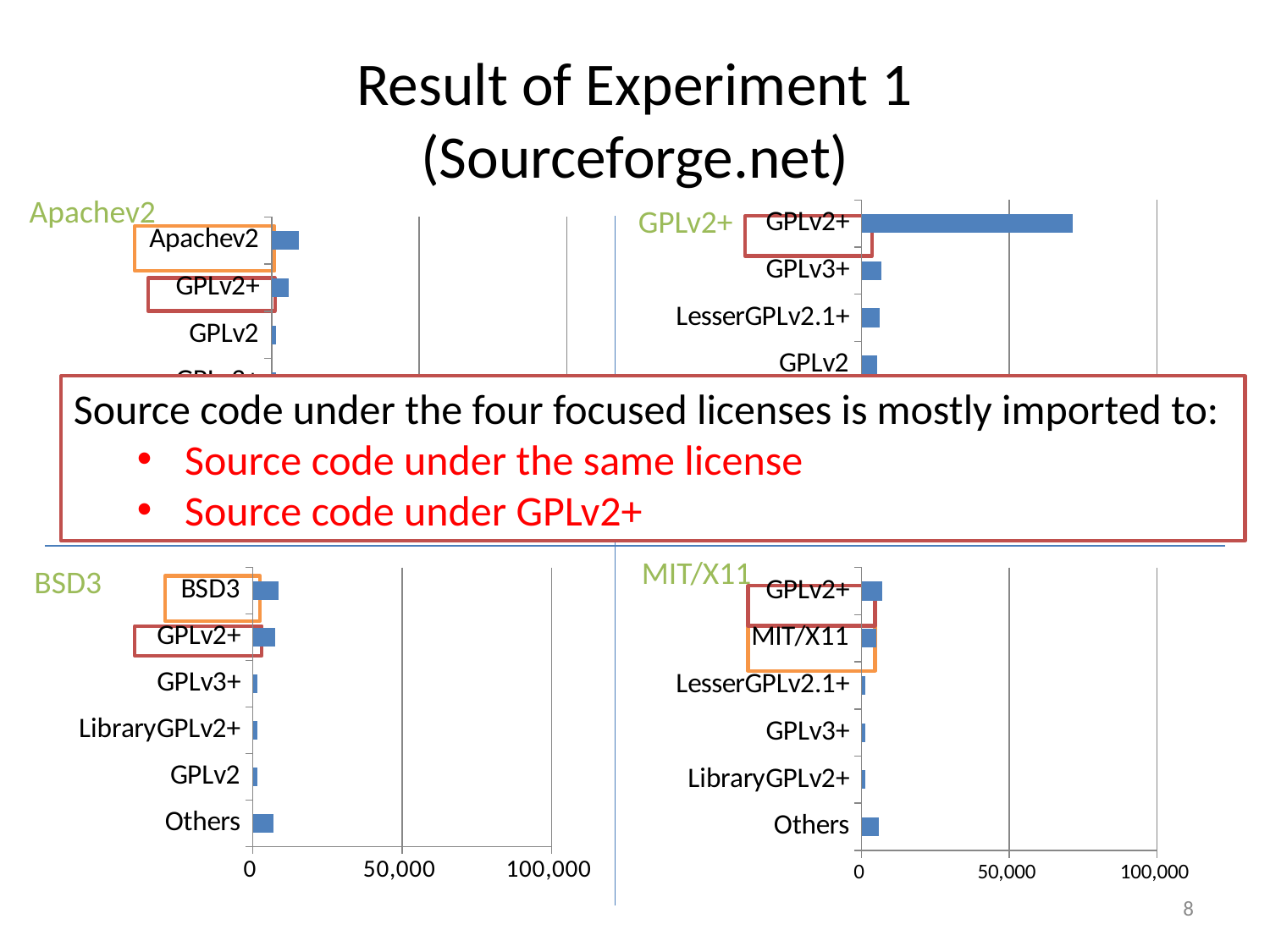
In the GPLv2+ chart (top right), which category has the highest value? GPLv2+ In the Apachev2 chart (top left), which is larger, the value for Apachev2 or the value for GPLv2? Apachev2 What is the highest value shown on the horizontal axis of the BSD3 chart (bottom left)? 100,000 In the BSD3 chart (bottom left), is the value for BSD3 greater or less than 50,000? less In the MIT/X11 chart (bottom right), which is larger, the value for GPLv2+ or the value for LesserGPLv2.1+? GPLv2+ In the BSD3 chart (bottom left), which is larger, the value for GPLv2+ or the value for GPLv3+? GPLv2+ In the GPLv2+ chart (top right), is the value for GPLv2+ greater or less than 50,000? greater How many categories are shown in the MIT/X11 chart (bottom right)? 6 What kind of chart is the GPLv2+ chart in the top right of the slide? bar chart In the MIT/X11 chart (bottom right), is the value for Others greater or less than 50,000? less How many categories are shown in the BSD3 chart (bottom left)? 6